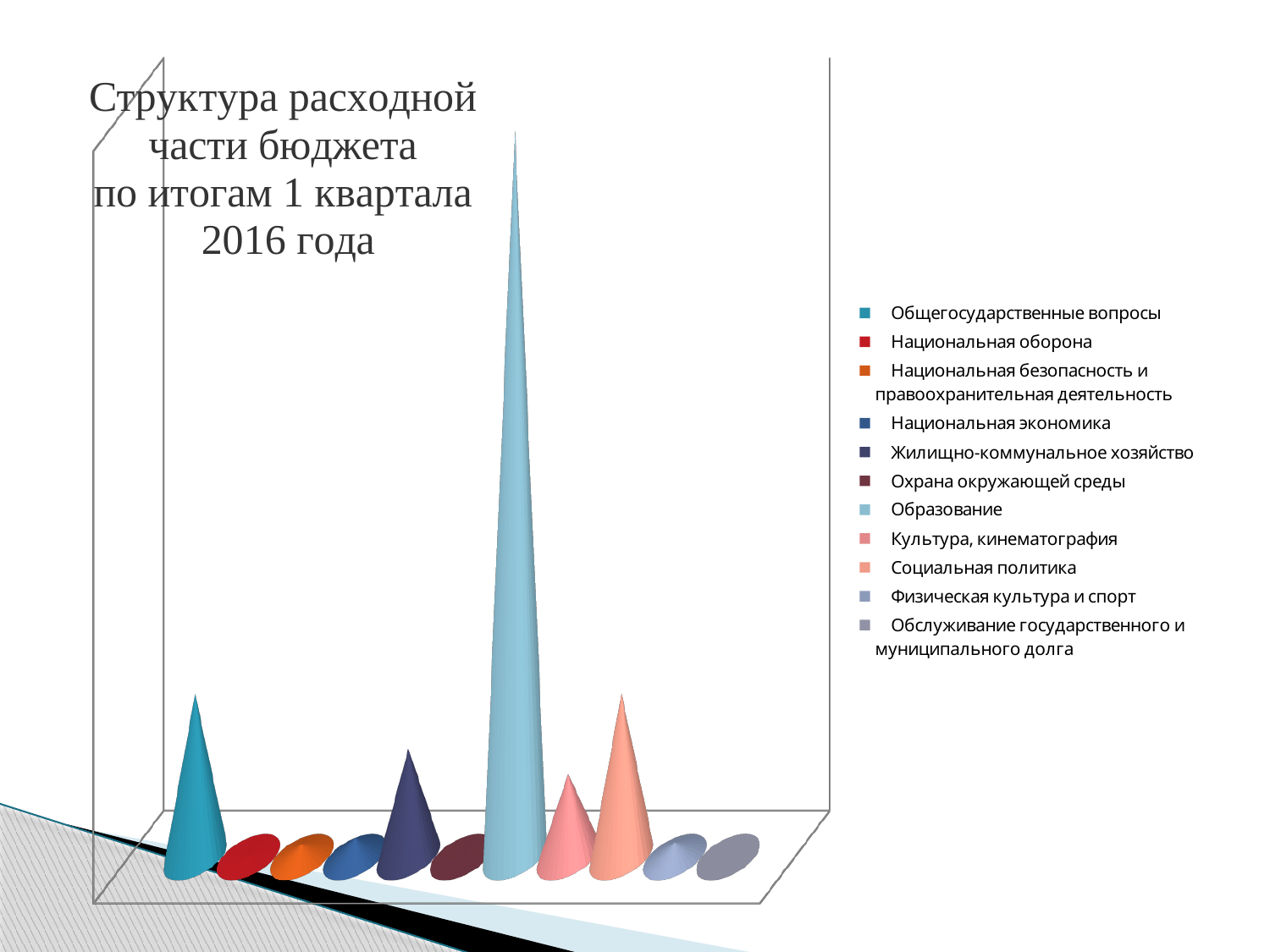
What is the title of the chart on the slide? Структура расходной части бюджета по итогам 1 квартала 2016 года Which is larger, the value for Образование or the value for Общегосударственные вопросы? Образование How many categories does the legend list? 11 Which legend entry is listed first in the chart's legend? Общегосударственные вопросы Which is larger, the value for Образование or the value for Социальная политика? Образование How many bars (cones) are plotted in the chart? 11 Which is larger, the value for Общегосударственные вопросы or the value for Национальная оборона? Общегосударственные вопросы Which category has the highest value in the chart? Образование What kind of chart is shown on the slide? bar chart